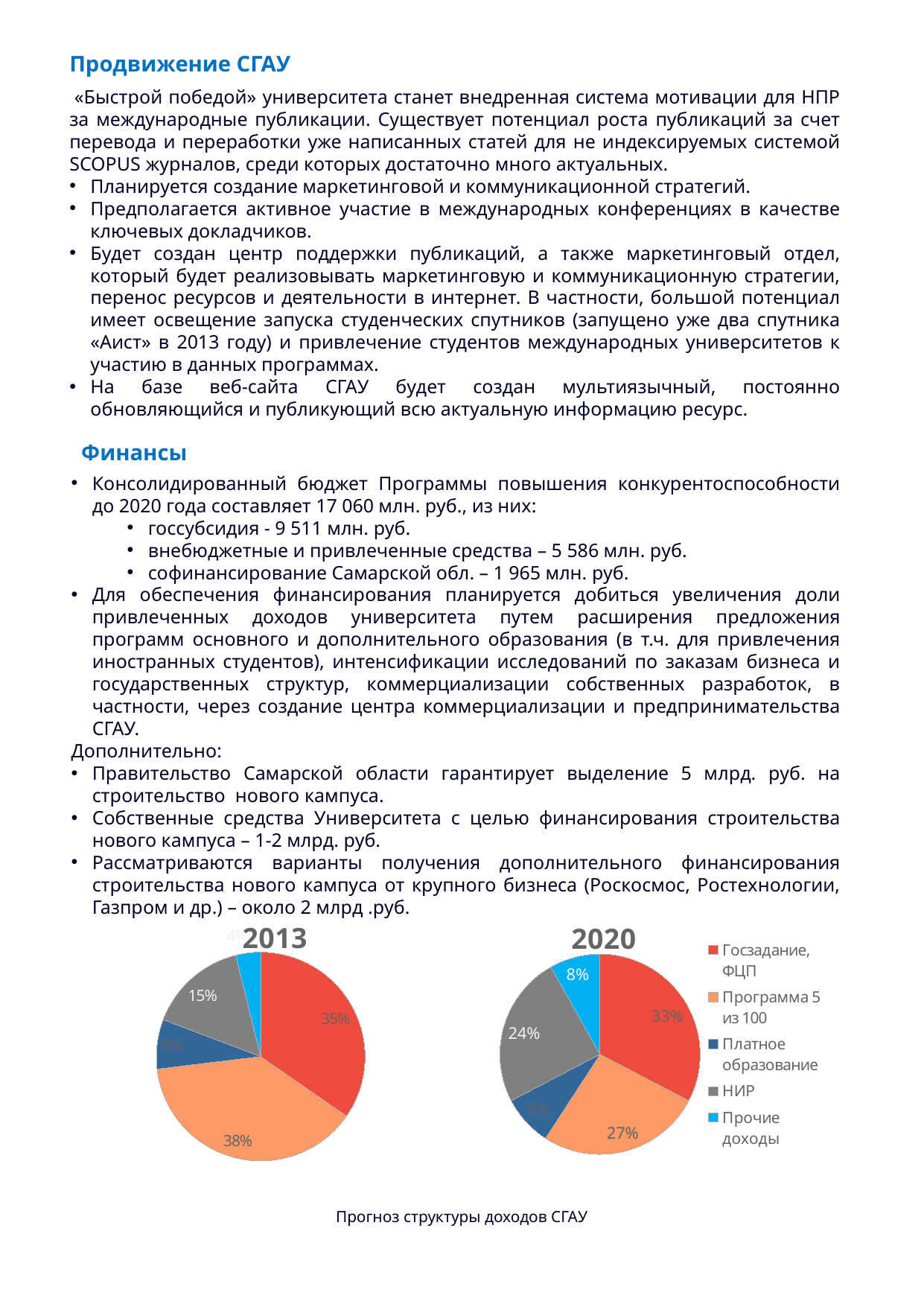
In the 2013 pie chart, which category has the largest share? Программа 5 из 100 In the 2013 pie chart, what share does Госзадание, ФЦП have? 35% How many categories does the legend list for the pie charts? 5 In the 2020 pie chart, what share does НИР have? 24% In the 2020 pie chart, what is the difference between the shares of Госзадание, ФЦП and Программа 5 из 100? 6% In the 2020 pie chart, which category has the largest share? Госзадание, ФЦП What colour represents Платное образование in the pie charts? Dark blue In the 2013 pie chart, which is larger: the share of НИР or the share of Платное образование? НИР In the 2013 pie chart, what share does Программа 5 из 100 have? 38% What type of chart is used to show the 2013 and 2020 income structure? Pie chart In the 2013 pie chart, which category has the smallest share? Прочие доходы In the 2020 pie chart, what share does Прочие доходы have? 8%